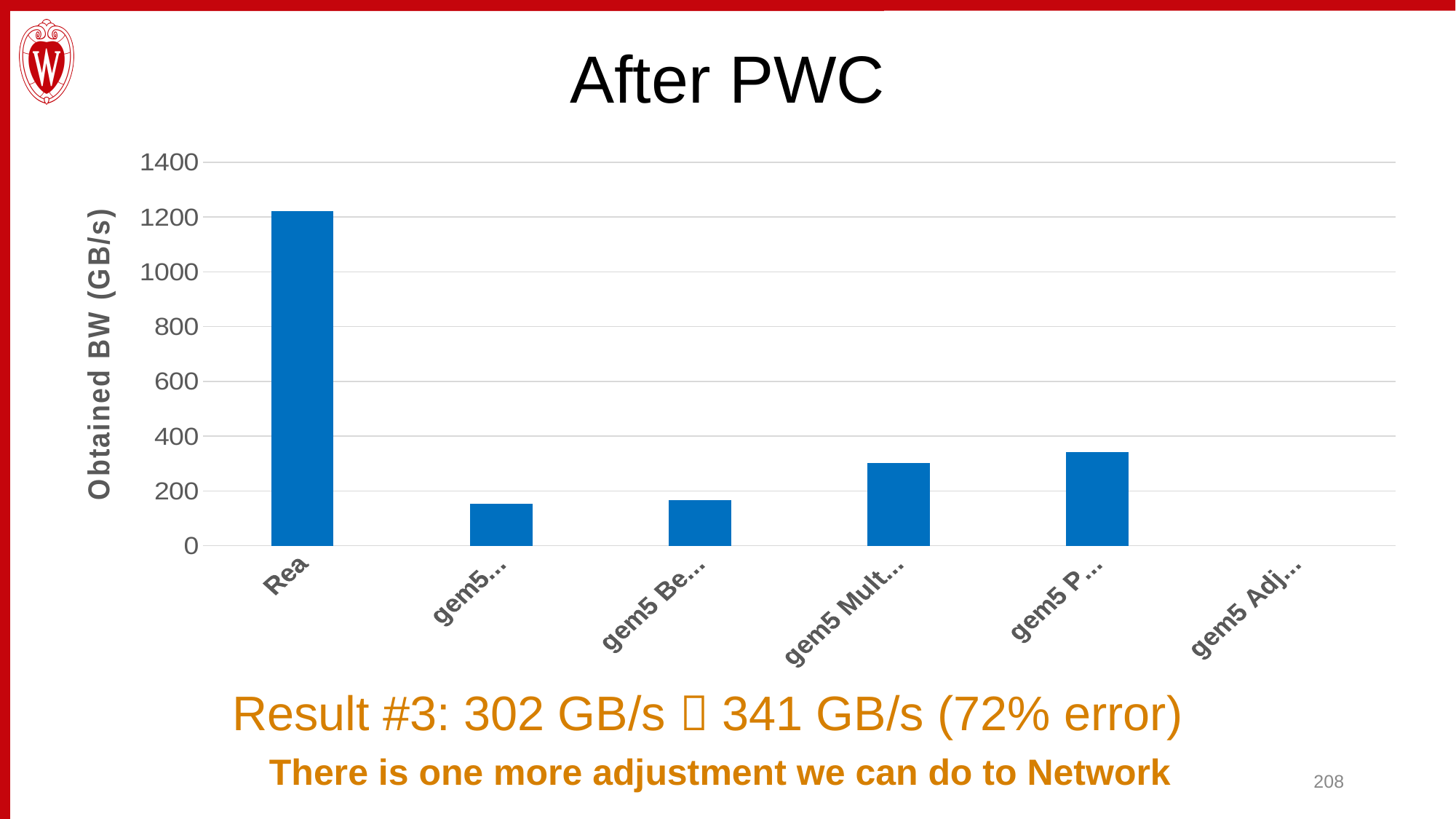
Which is larger, the value for Rea or the value for gem5 P…? Rea Is the value for gem5 Be… greater or less than 200? less Which category has the highest Obtained BW? Rea Is the value for Rea greater or less than 1000? greater Is the value for gem5 P… greater or less than 400? less Which is larger, the value for gem5 P… or the value for gem5 Mult…? gem5 P… How many category labels are shown on the x axis? 6 What is the label of the y axis? Obtained BW (GB/s) What kind of chart is shown on the slide? bar chart